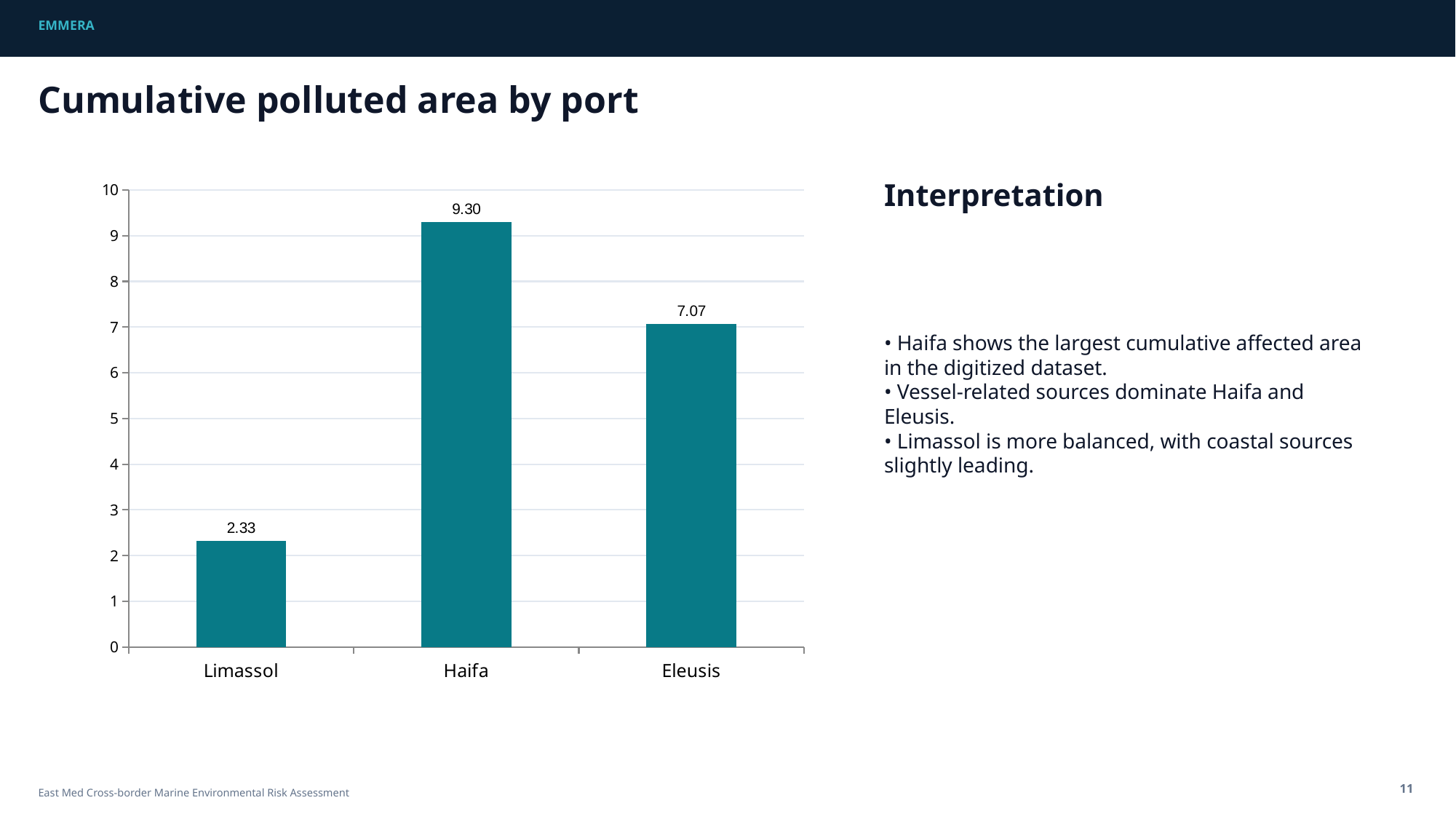
What is the title of the chart on the slide? Cumulative polluted area by port What is the cumulative polluted area value for Haifa? 9.30 Which is larger, the value for Eleusis or the value for Limassol? Eleusis What kind of chart is shown on the slide? Bar chart What is the cumulative polluted area value for Limassol? 2.33 What is the difference between the values for Eleusis and Limassol? 4.74 How many ports are shown on the chart? 3 What is the cumulative polluted area value for Eleusis? 7.07 What is the difference between the values for Haifa and Eleusis? 2.23 Which port has the lowest cumulative polluted area? Limassol Which port has the highest cumulative polluted area? Haifa Is the value for Haifa greater or less than 9? greater